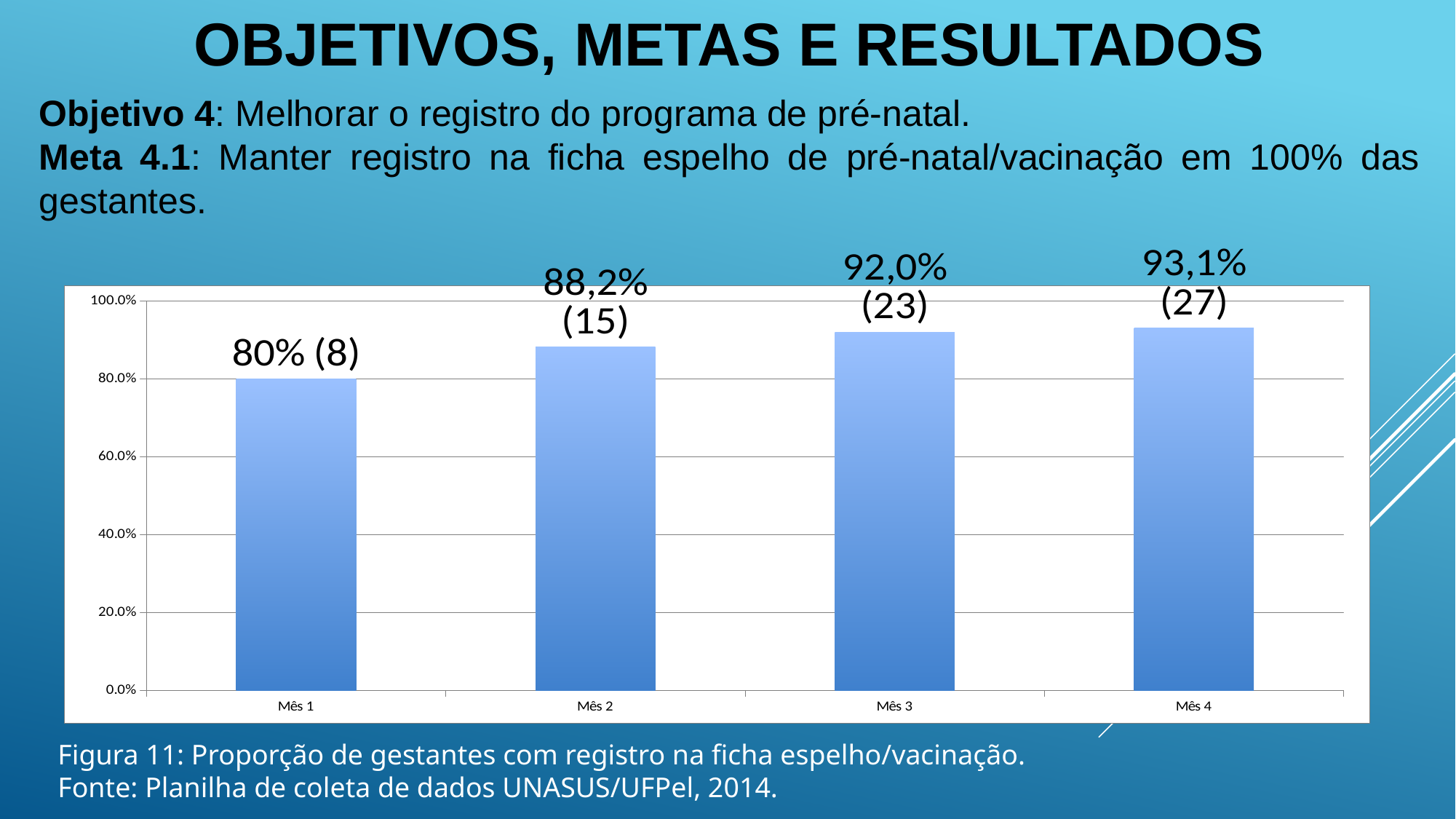
Is the value for Mês 2 greater or less than 80.0%? greater What kind of chart is shown on the slide? Bar chart Which is larger, the value for Mês 2 or the value for Mês 3? Mês 3 Which month has the highest value? Mês 4 What is the difference in percentage points between Mês 3 and Mês 1? 12,0 What percentage is shown for Mês 2? 88,2% How many months (categories) are shown on the x axis? 4 What is the value shown for Mês 1? 80% (8) Do the values rise or fall from Mês 1 to Mês 4? Rise What percentage is shown for Mês 4? 93,1% What is the count in parentheses shown for Mês 3? 23 Which month has the lowest value? Mês 1